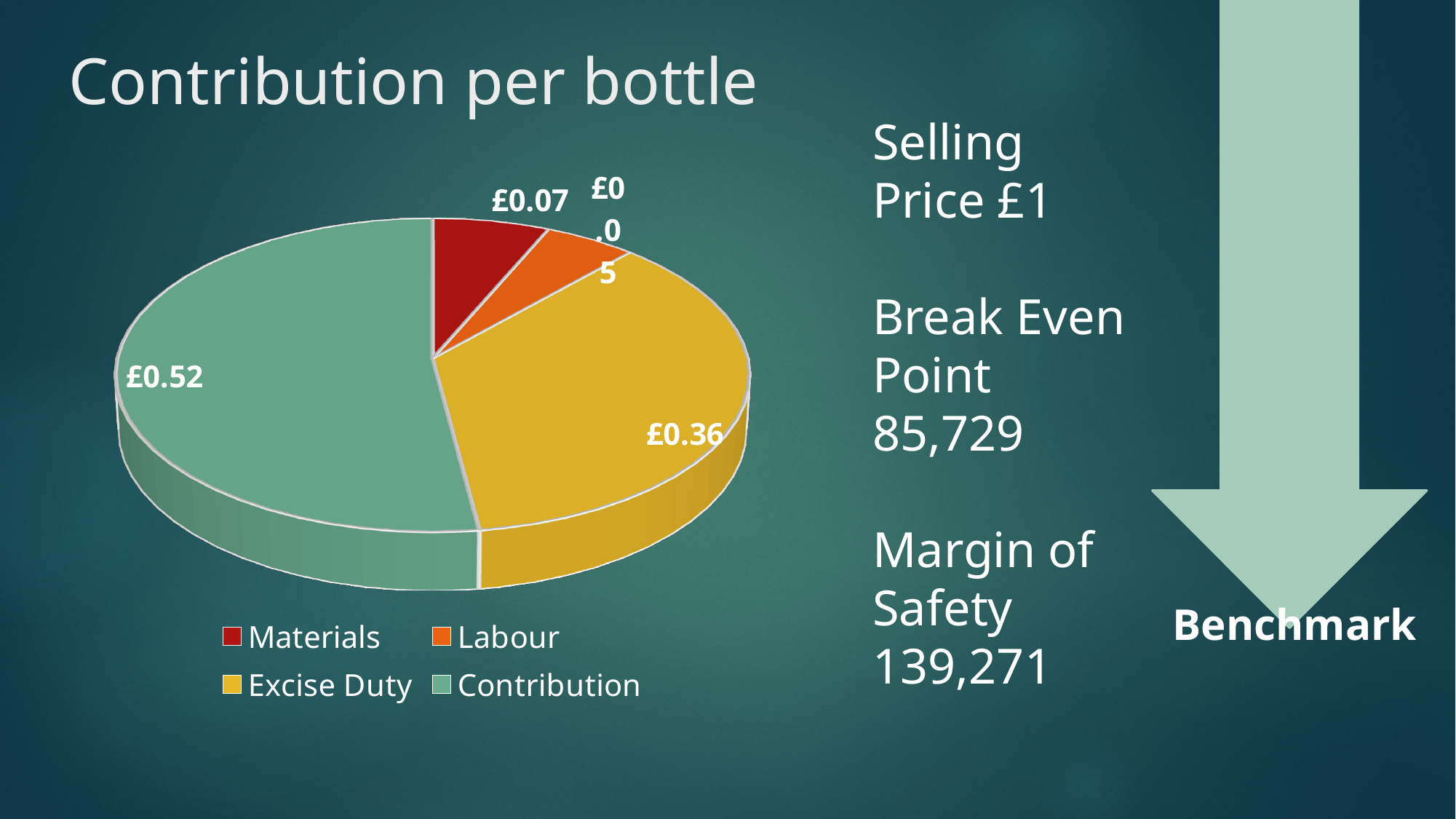
What is the difference between the Contribution value and the Excise Duty value? £0.16 What is the value for Contribution in the pie chart? £0.52 What is the value for Materials in the pie chart? £0.07 Which category has the smallest slice of the pie chart? Labour Which is larger, the value for Materials or the value for Labour? Materials What is the value for Labour in the pie chart? £0.05 Which category has the largest slice of the pie chart? Contribution How many slices does the pie chart have? 4 What share of the pie does Contribution represent? 52% What kind of chart is shown on the slide? pie chart What is the title of the chart? Contribution per bottle What is the value for Excise Duty in the pie chart? £0.36